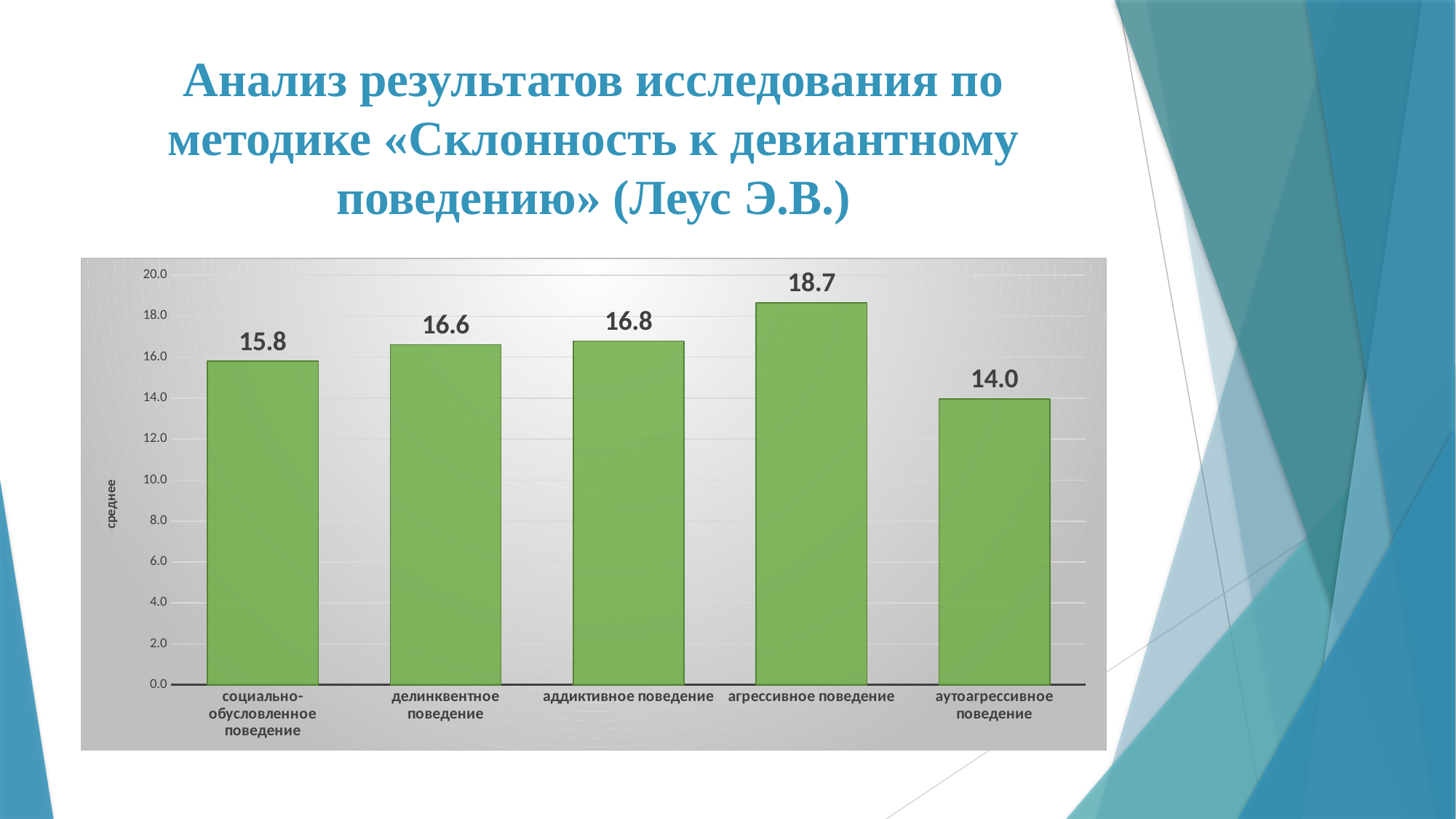
What is the value for аутоагрессивное поведение? 14.0 How many categories are shown on the x axis? 5 What is the value for социально-обусловленное поведение? 15.8 Is the value for аддиктивное поведение greater or less than 16.0? greater Which is larger, the value for делинквентное поведение or the value for социально-обусловленное поведение? делинквентное поведение What kind of chart is shown on the slide? bar chart What is the label of the vertical axis? среднее What is the difference between the values for агрессивное поведение and аутоагрессивное поведение? 4.7 What is the value for агрессивное поведение? 18.7 Which category has the lowest value? аутоагрессивное поведение Which category has the highest value? агрессивное поведение What is the difference between the values for аддиктивное поведение and делинквентное поведение? 0.2